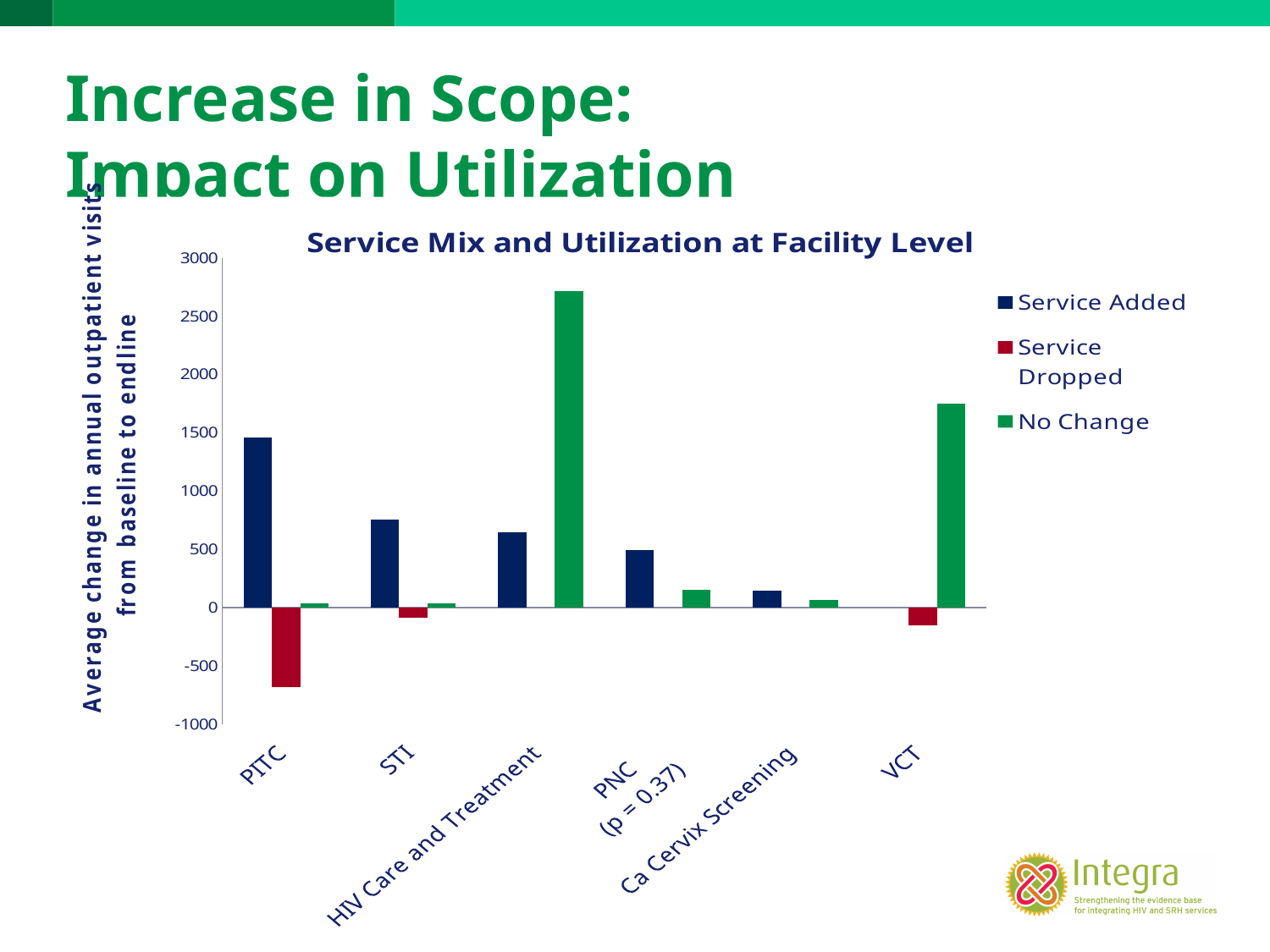
Is the No Change value for HIV Care and Treatment greater or less than 2500? greater What kind of chart is shown on the slide? bar chart Is the Service Dropped value for PITC greater or less than -500? less Which category has the lowest (most negative) Service Dropped bar? PITC Which category has the highest No Change bar? HIV Care and Treatment Which has the larger Service Added value, STI or PNC (p = 0.37)? STI What is the title of the chart? Service Mix and Utilization at Facility Level Is the No Change value for VCT greater or less than 1500? greater Which category has the highest Service Added bar? PITC How many series does the legend list? 3 How many service categories are shown on the x axis? 6